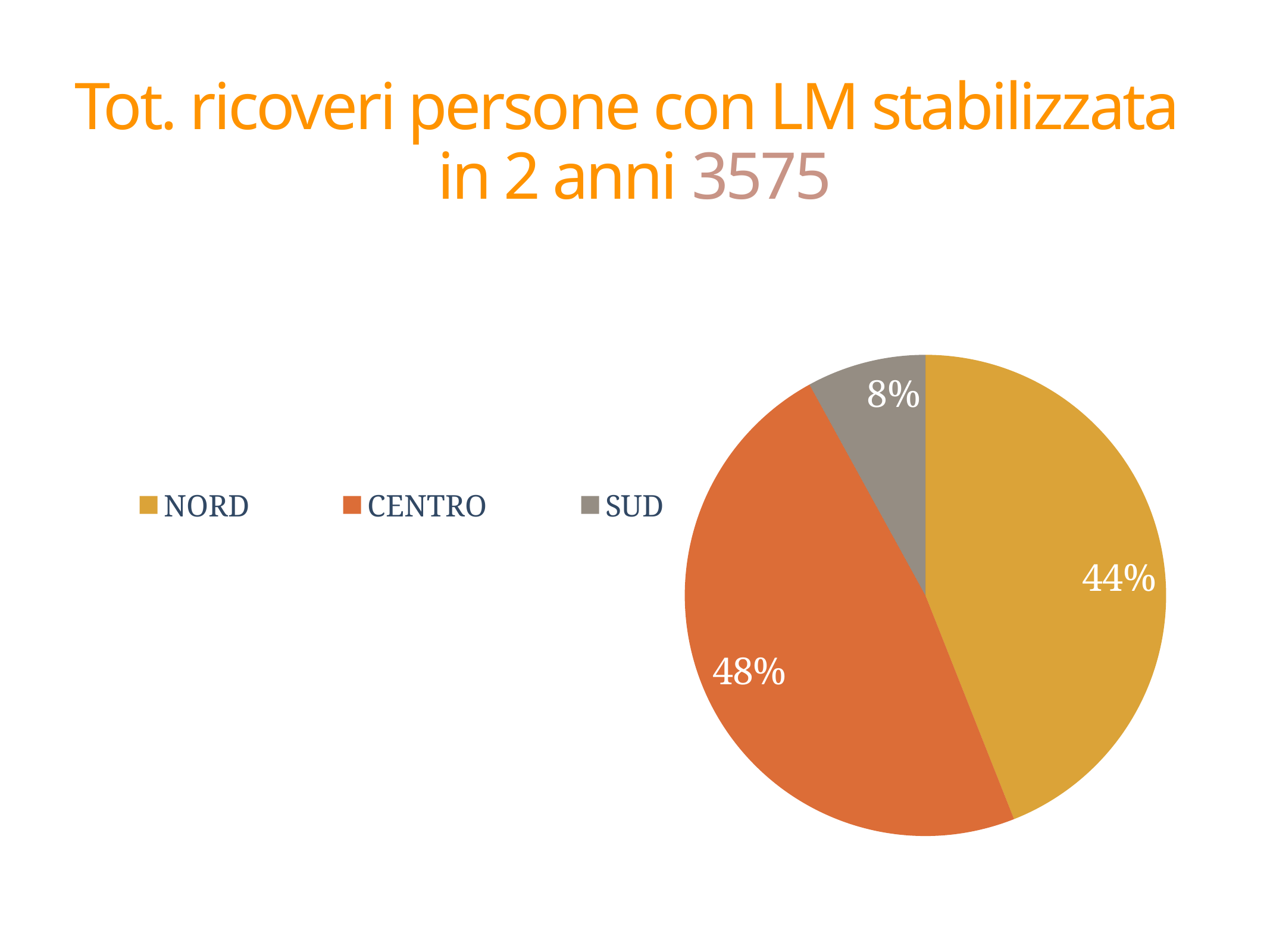
What share of the pie does SUD represent? 8% Which is larger, the share for NORD or the share for SUD? NORD What kind of chart is shown on the slide? pie chart What share of the pie does CENTRO represent? 48% Which category has the largest slice of the pie? CENTRO How many categories does the pie chart show? 3 What is the difference in percentage points between NORD and SUD? 36 What share of the pie does NORD represent? 44% Which category has the smallest slice of the pie? SUD What is the difference in percentage points between CENTRO and NORD? 4 What colour is the slice for SUD? grey What total number of hospitalisations is stated in the slide title? 3575